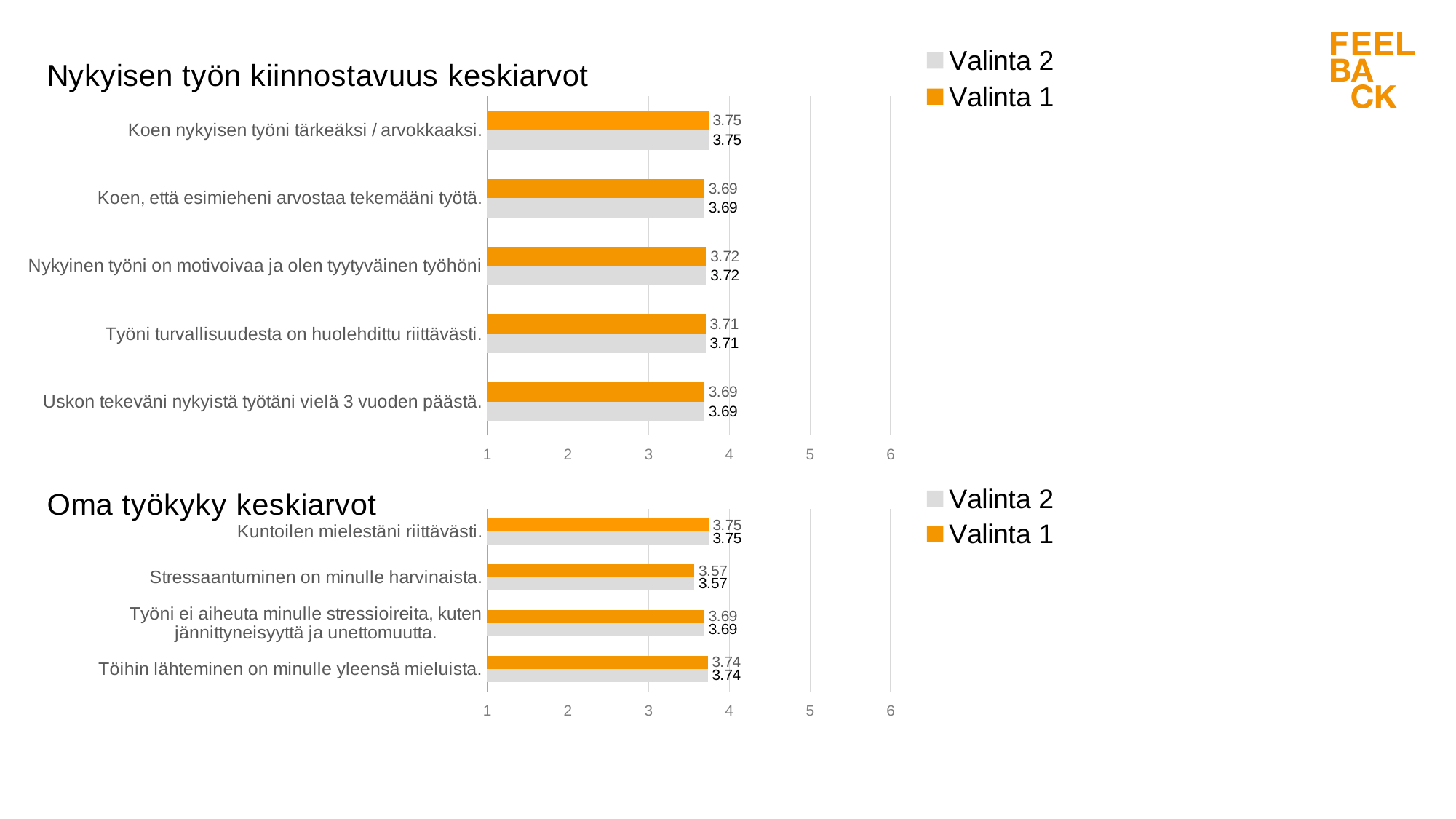
In the 'Oma työkyky keskiarvot' chart, how many categories are shown? 4 In the 'Oma työkyky keskiarvot' chart, which category has the lowest Valinta 2 value? Stressaantuminen on minulle harvinaista. In the 'Nykyisen työn kiinnostavuus keskiarvot' chart, what is the Valinta 2 value for 'Työni turvallisuudesta on huolehdittu riittävästi.'? 3.71 What kind of chart is 'Oma työkyky keskiarvot'? Bar chart In the 'Oma työkyky keskiarvot' chart, what is the Valinta 1 value for 'Stressaantuminen on minulle harvinaista.'? 3.57 In the 'Nykyisen työn kiinnostavuus keskiarvot' chart, which category has the highest Valinta 1 value? Koen nykyisen työni tärkeäksi / arvokkaaksi. In the 'Nykyisen työn kiinnostavuus keskiarvot' chart, how many series does the legend list? 2 In the 'Oma työkyky keskiarvot' chart, which category has the highest Valinta 1 value? Kuntoilen mielestäni riittävästi. In the 'Oma työkyky keskiarvot' chart, what is the difference between the Valinta 1 values for 'Kuntoilen mielestäni riittävästi.' and 'Stressaantuminen on minulle harvinaista.'? 0.18 In the 'Nykyisen työn kiinnostavuus keskiarvot' chart, which colour represents Valinta 1? Orange In the 'Nykyisen työn kiinnostavuus keskiarvot' chart, how many categories are shown? 5 In the 'Nykyisen työn kiinnostavuus keskiarvot' chart, what is the Valinta 1 value for 'Koen nykyisen työni tärkeäksi / arvokkaaksi.'? 3.75